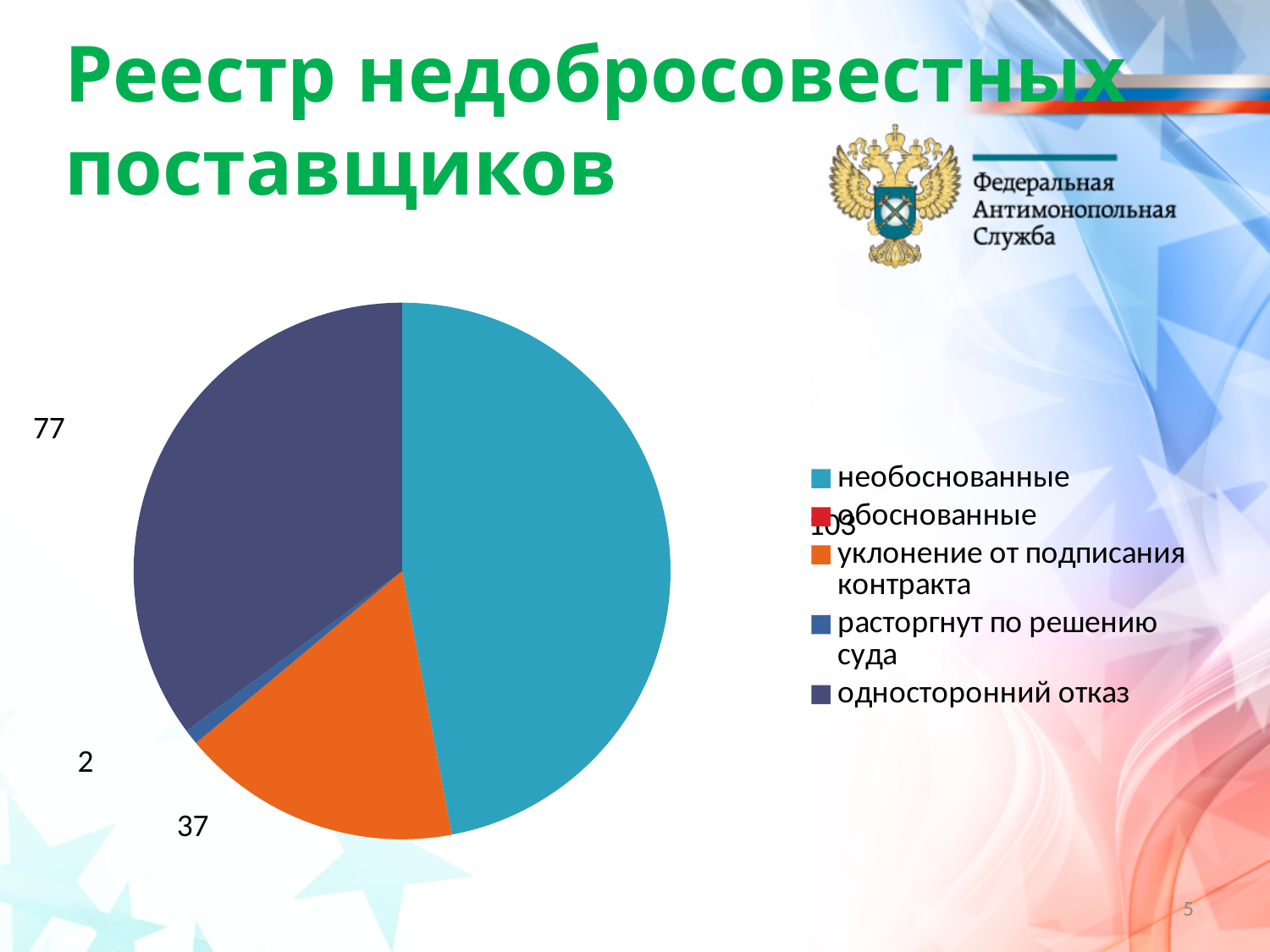
What is the value shown for the 'необоснованные' slice? 103 Which of the slices with a printed value is the smallest? расторгнут по решению суда How many entries does the legend of the pie chart list? 5 Which is larger: the slice for 'односторонний отказ' or the slice for 'уклонение от подписания контракта'? односторонний отказ What kind of chart is shown on the slide? pie chart Which category has the largest slice of the pie? необоснованные What is the title of the slide containing the pie chart? Реестр недобросовестных поставщиков What is the difference between the values for 'односторонний отказ' and 'уклонение от подписания контракта'? 40 What is the value shown for the 'расторгнут по решению суда' slice? 2 What is the value shown for the 'уклонение от подписания контракта' slice? 37 What is the value shown for the 'односторонний отказ' slice? 77 What is the difference between the values for 'необоснованные' and 'односторонний отказ'? 26